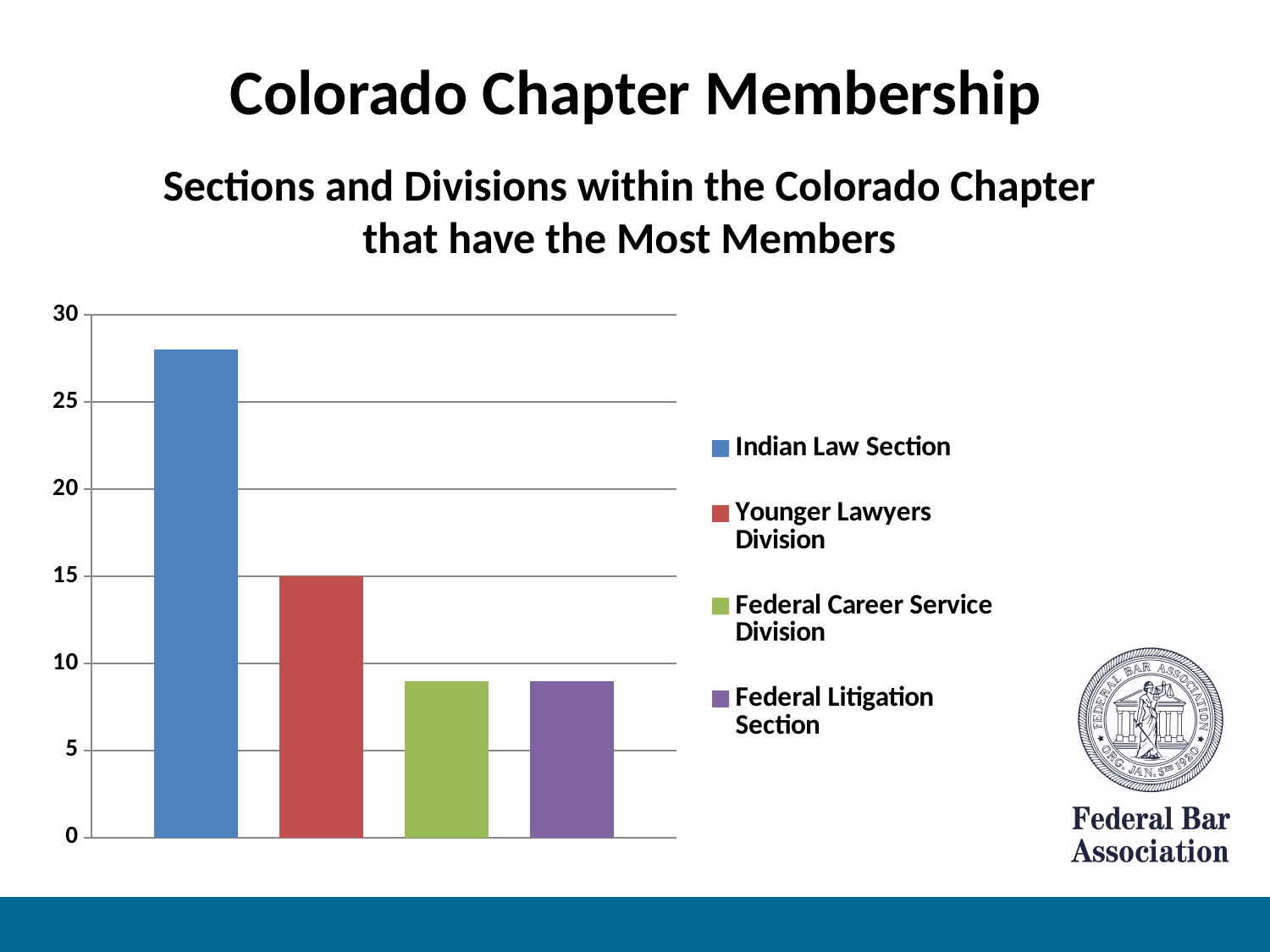
What colour is the bar for the Indian Law Section? blue Which is larger, the value for the Indian Law Section or the Younger Lawyers Division? Indian Law Section Which section or division has the highest number of members? Indian Law Section What is the value for the Younger Lawyers Division? 15 How many bars are plotted in the chart? 4 Is the value for the Federal Litigation Section greater or less than 10? less What kind of chart is shown on the slide? bar chart Is the value for the Federal Career Service Division greater or less than 10? less Which is larger, the value for the Younger Lawyers Division or the Federal Litigation Section? Younger Lawyers Division How many entries does the legend list? 4 What is the title of the chart? Sections and Divisions within the Colorado Chapter that have the Most Members Is the value for the Indian Law Section greater or less than 25? greater